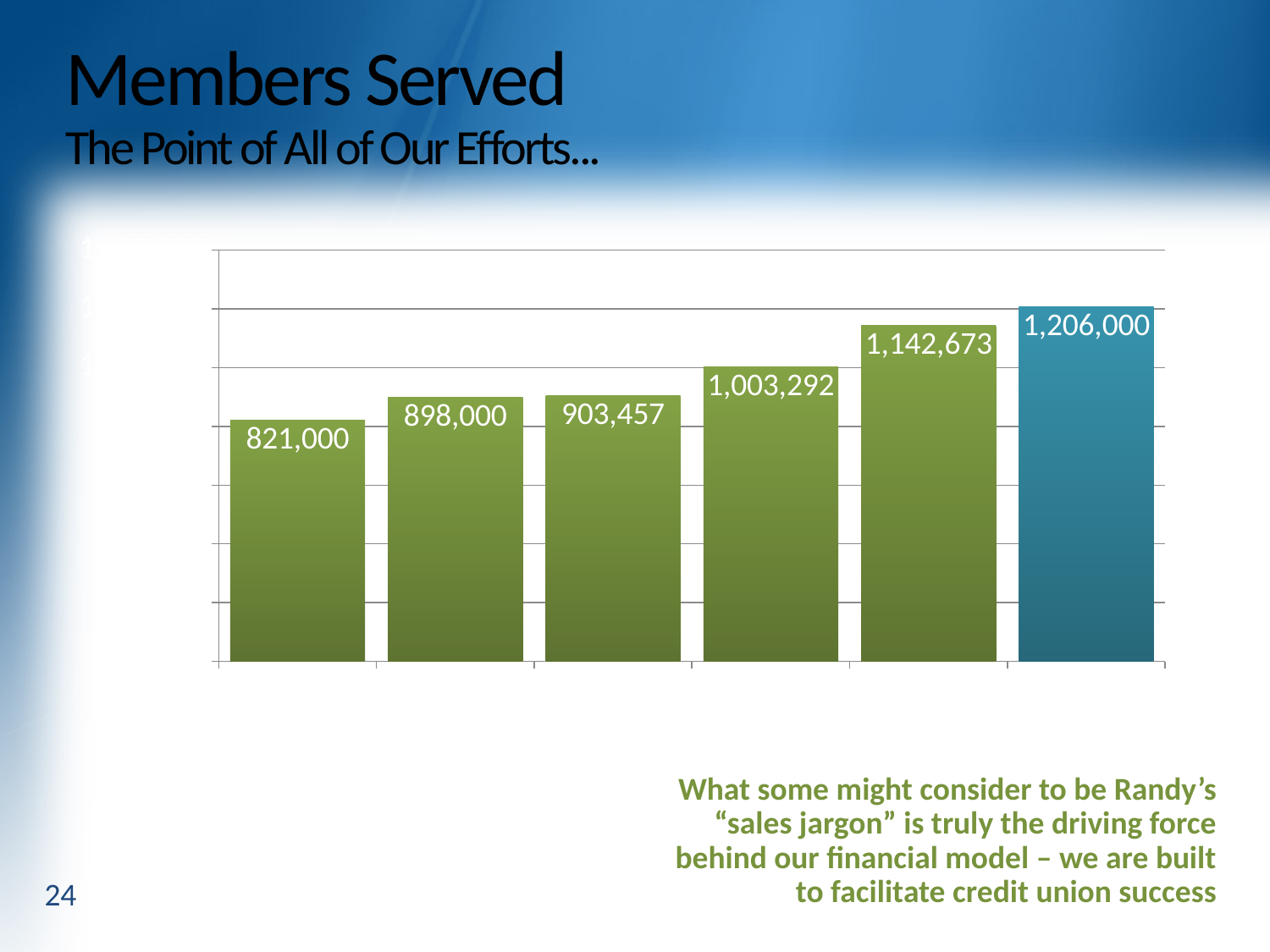
Do the values rise or fall from left to right across the chart? rise What colour is the rightmost bar, which differs from the others? blue What is the highest value shown in the chart? 1,206,000 What is the value shown on the third bar from the left? 903,457 Which is larger, the second bar or the third bar from the left? the third bar (903,457) What is the difference between the rightmost bar (1,206,000) and the leftmost bar (821,000)? 385,000 What is the value shown on the fourth bar from the left? 1,003,292 How many bars are plotted in the chart? 6 What type of chart is shown on the slide? bar chart What is the lowest value shown in the chart? 821,000 What is the value shown on the first (leftmost) bar? 821,000 What is the value shown on the last (rightmost) bar? 1,206,000